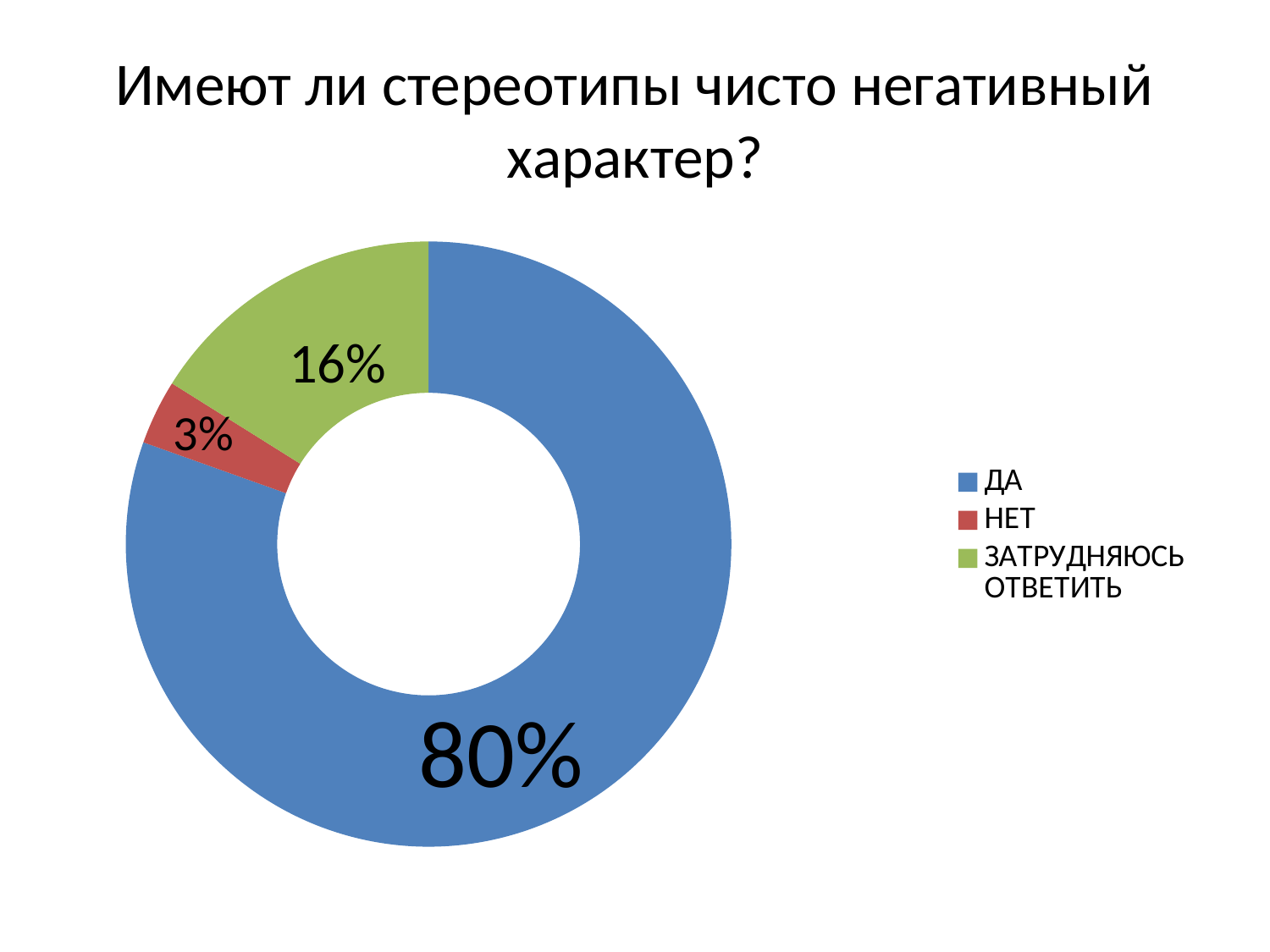
What kind of chart is shown on the slide? Doughnut (pie) chart What is the value shown for ЗАТРУДНЯЮСЬ ОТВЕТИТЬ? 16% What is the difference between the ДА and ЗАТРУДНЯЮСЬ ОТВЕТИТЬ values? 64% What is the difference between the ЗАТРУДНЯЮСЬ ОТВЕТИТЬ and НЕТ values? 13% What is the title of the chart? Имеют ли стереотипы чисто негативный характер? Which category has the smallest slice? НЕТ Which is larger, the value for НЕТ or the value for ЗАТРУДНЯЮСЬ ОТВЕТИТЬ? ЗАТРУДНЯЮСЬ ОТВЕТИТЬ What is the value shown for НЕТ? 3% What share of the chart does the ДА slice represent? 80% What colour is the ДА slice? Blue Which category has the largest slice? ДА How many categories does the chart show? 3